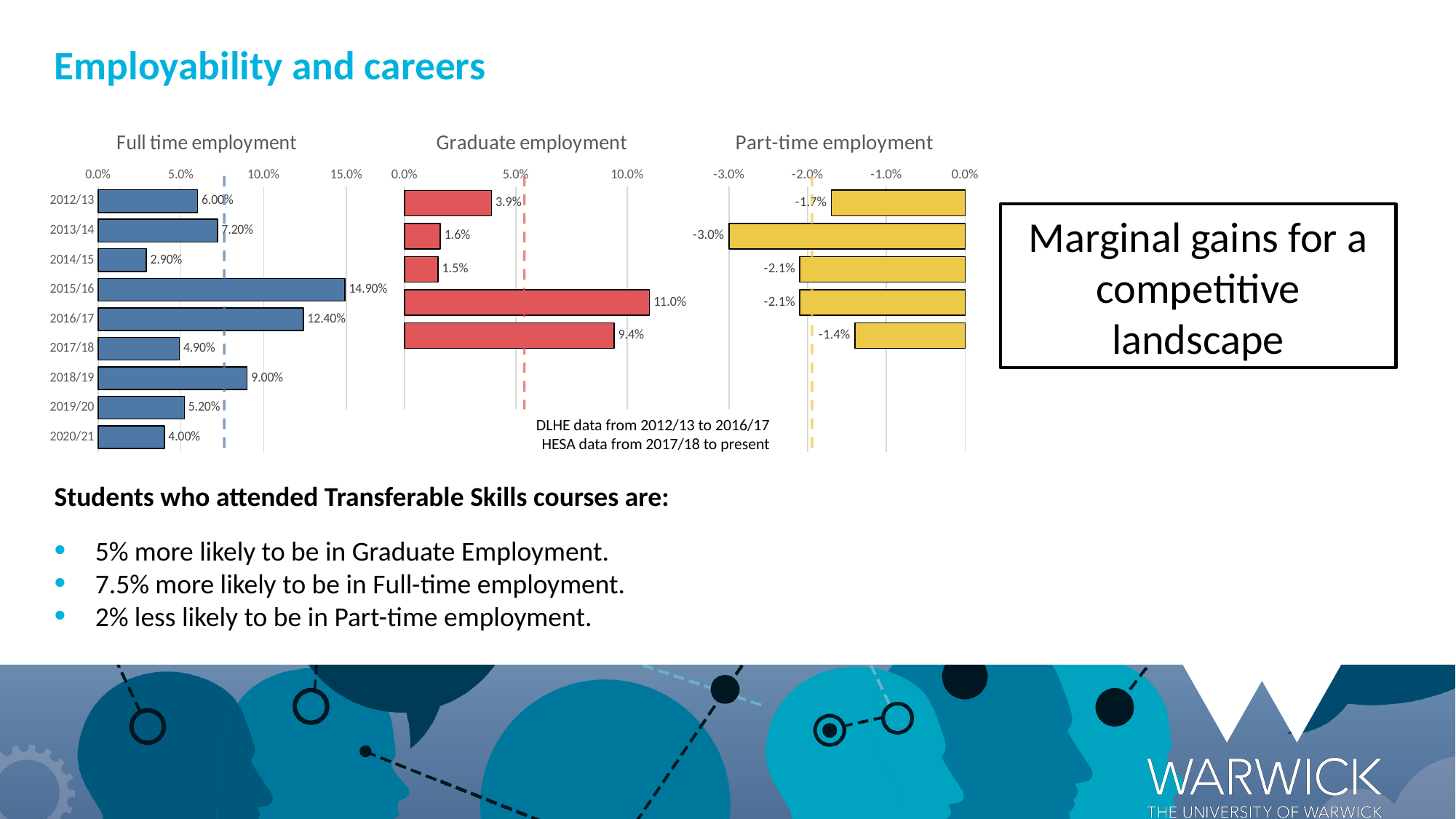
In the Full time employment chart, what is the value for 2020/21? 4.00% In the Graduate employment chart, what is the highest value shown? 11.0% In the Full time employment chart, which is larger: the value for 2013/14 or the value for 2018/19? 2018/19 What kind of chart is the Graduate employment chart? Bar chart In the Full time employment chart, what is the difference between the values for 2015/16 and 2016/17? 2.50% In the Full time employment chart, what is the value for 2015/16? 14.90% In the Full time employment chart, which year has the highest value? 2015/16 How many bars are shown in the Part-time employment chart? 5 In the Part-time employment chart, what is the lowest value shown? -3.0% In the Full time employment chart, which year has the lowest value? 2014/15 In the Full time employment chart, is the value for 2016/17 greater or less than 10.0%? greater How many years are shown in the Full time employment chart? 9